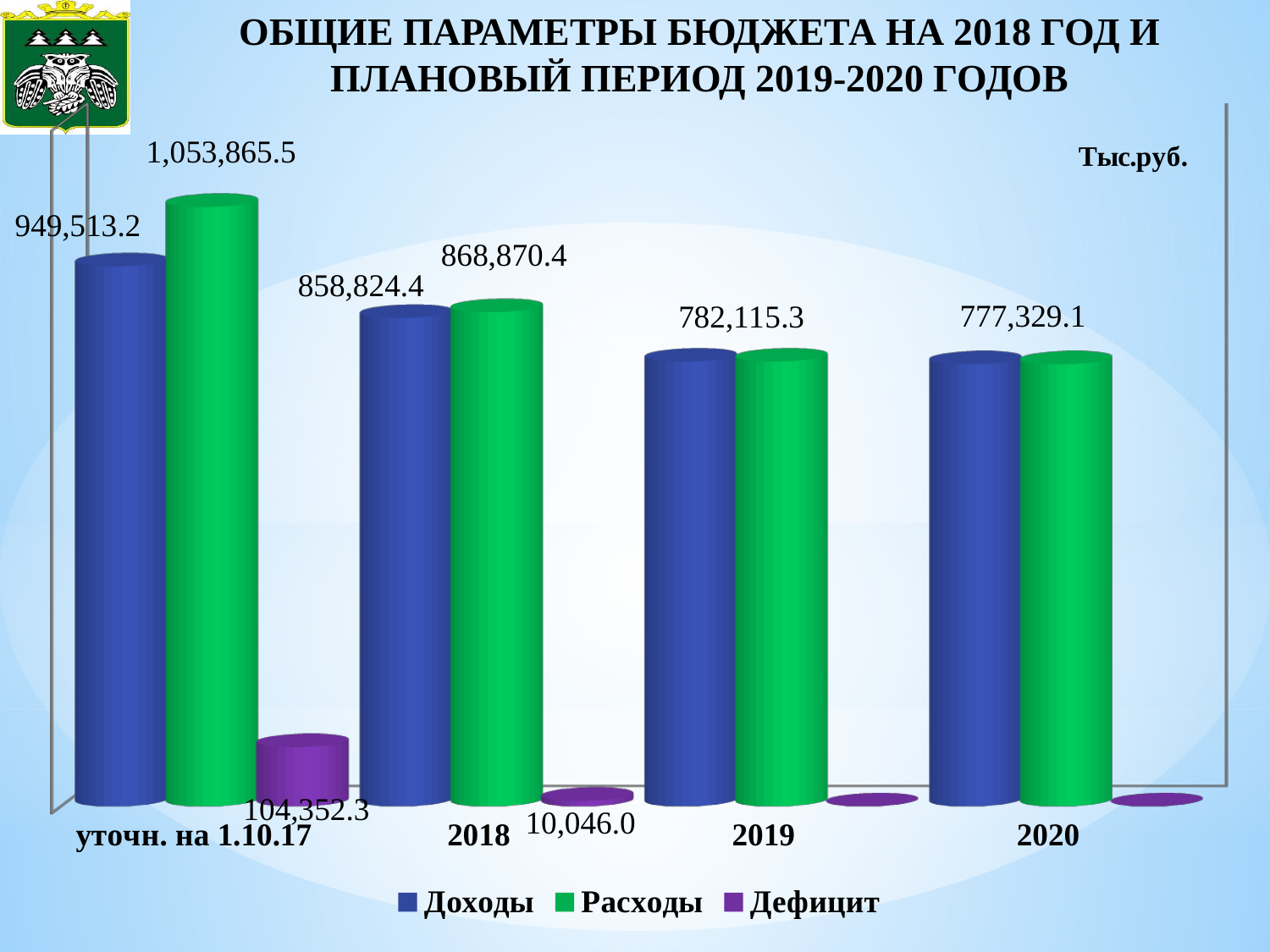
What is the value of Дефицит for 2018? 10,046.0 What unit is indicated in the top right of the chart? Тыс.руб. What value is printed above the bars for 2019? 782,115.3 What kind of chart is shown on the slide? bar chart In which category is Расходы the highest? уточн. на 1.10.17 What is the value of Расходы for уточн. на 1.10.17? 1,053,865.5 How many series does the legend list? 3 What is the difference between Расходы and Доходы for 2018? 10,046.0 What is the value of Дефицит for уточн. на 1.10.17? 104,352.3 Do the Доходы values rise or fall from уточн. на 1.10.17 to 2020? fall How many categories are shown along the x axis? 4 What is the value of Доходы for уточн. на 1.10.17? 949,513.2